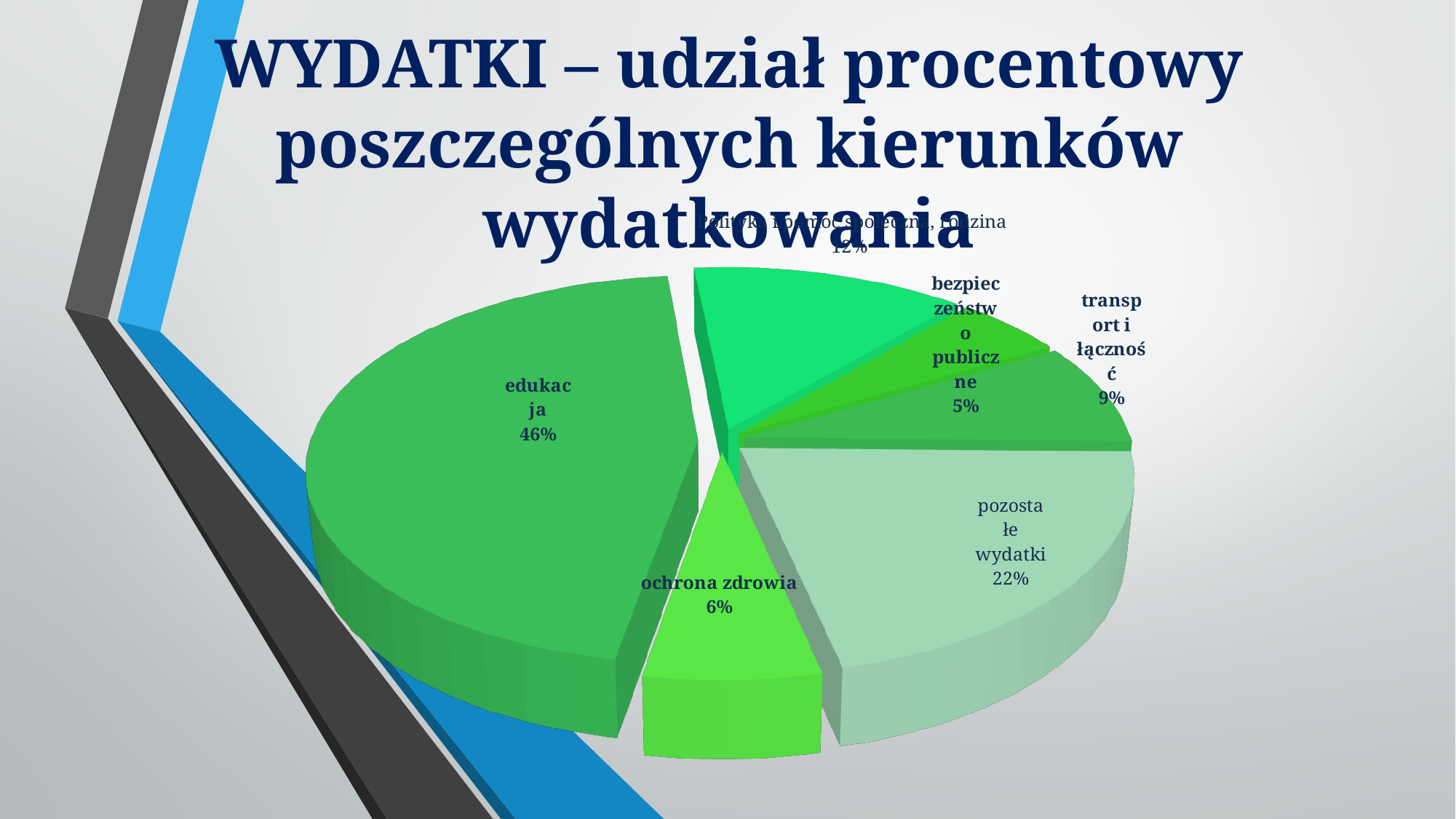
What share of expenditure does the 'edukacja' slice represent? 46% What percentage is shown for 'pozostałe wydatki'? 22% What kind of chart is shown on the slide? pie chart Which category has the smallest share of the pie? bezpieczeństwo publiczne Which has a larger share: 'transport i łączność' or 'ochrona zdrowia'? transport i łączność Which category has the largest share of the pie? edukacja How many slices does the pie chart have? 6 What percentage is shown for 'bezpieczeństwo publiczne'? 5% What percentage is shown for 'transport i łączność'? 9% What percentage is shown for 'ochrona zdrowia'? 6% What is the title of the slide? WYDATKI – udział procentowy poszczególnych kierunków wydatkowania By how many percentage points does 'edukacja' exceed 'pozostałe wydatki'? 24 percentage points